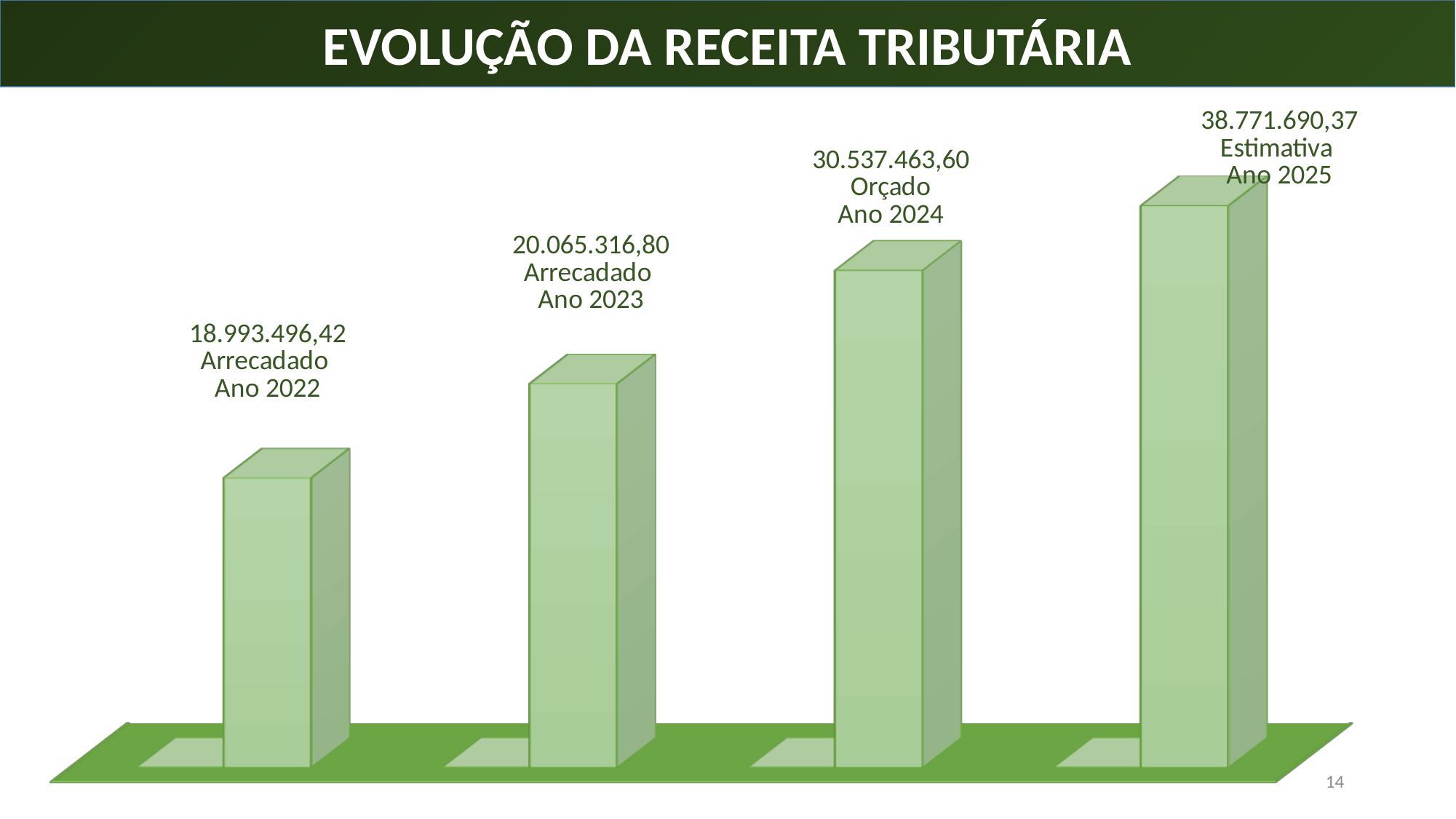
What is the difference between the value for Estimativa Ano 2025 and the value for Orçado Ano 2024? 8.234.226,77 What is the value shown for Arrecadado Ano 2022? 18.993.496,42 Which year has the lowest value on the chart? Arrecadado Ano 2022 What is the value shown for Orçado Ano 2024? 30.537.463,60 What is the value shown for Arrecadado Ano 2023? 20.065.316,80 What is the value shown for Estimativa Ano 2025? 38.771.690,37 Which year has the highest value on the chart? Estimativa Ano 2025 How many bars are shown on the chart? 4 Do the values rise or fall from Ano 2022 to Ano 2025? Rise What kind of chart is shown on the slide? Bar chart What is the difference between the value for Ano 2023 and the value for Ano 2022? 1.071.820,38 Which is larger, the value for Orçado Ano 2024 or the value for Arrecadado Ano 2023? Orçado Ano 2024